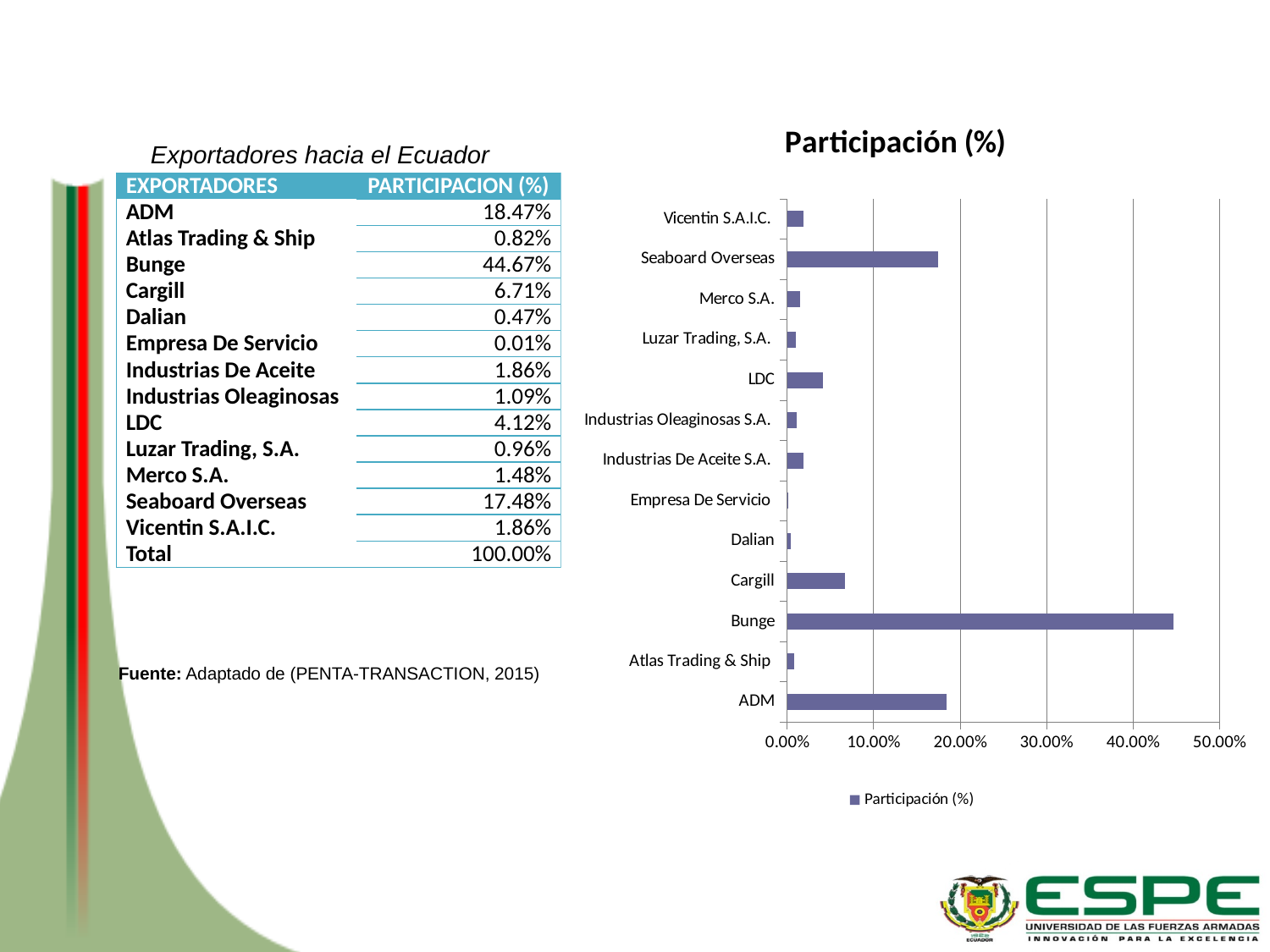
Which exporter has the lowest participation in the chart? Empresa De Servicio Is the value for Seaboard Overseas greater or less than 20.00%? less How many exporters (categories) are plotted in the chart? 13 What type of chart is shown on the slide? bar chart How many series does the chart legend list? 1 What is the participation (%) for ADM? 18.47% Which has a larger participation, Cargill or LDC? Cargill What is the participation (%) for Bunge? 44.67% What is the difference in participation between Bunge and ADM? 26.20% Is the value for Bunge greater or less than 40.00%? greater What is the title of the chart? Participación (%) Which exporter has the highest participation in the chart? Bunge